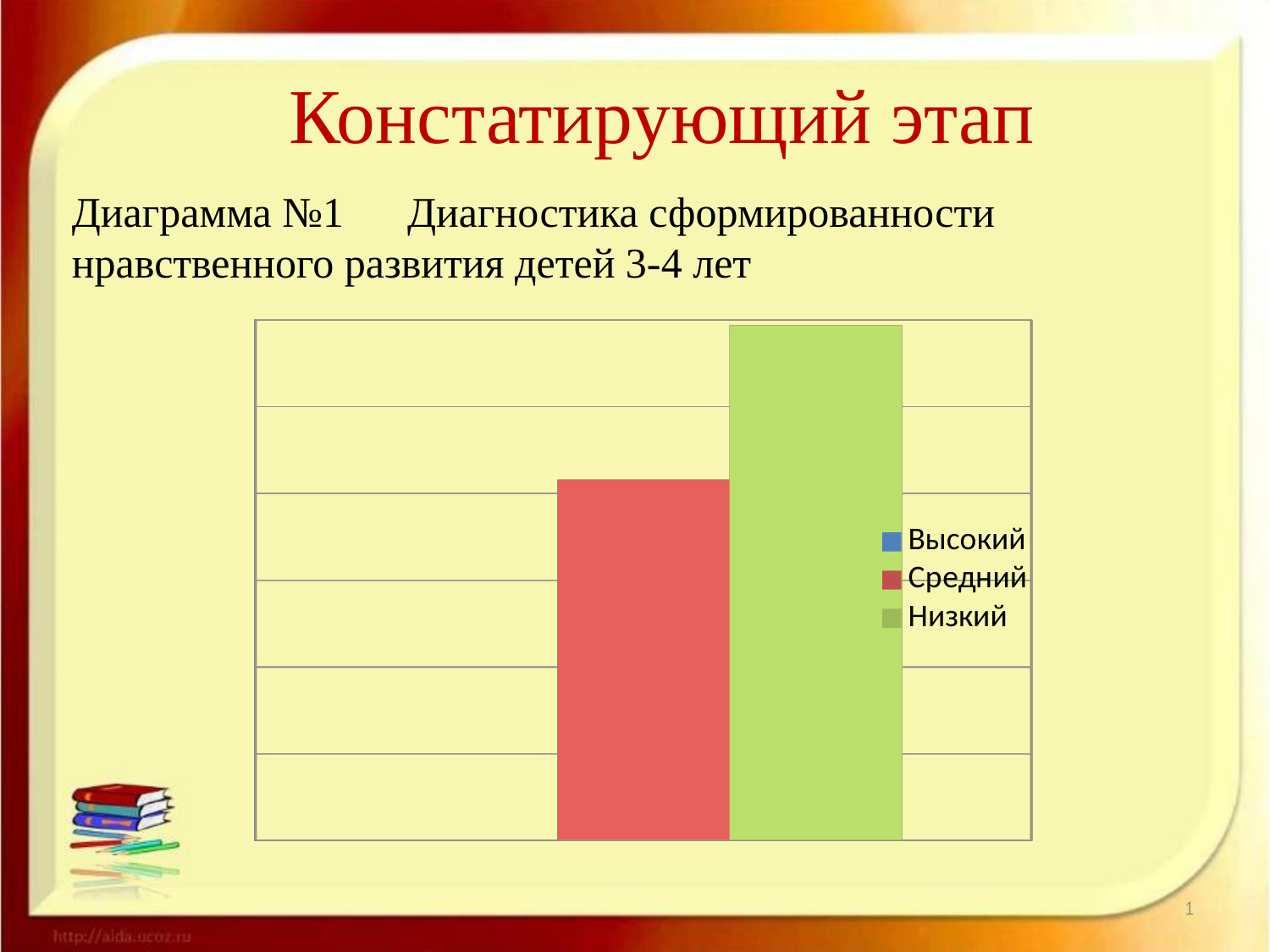
Which is larger, the bar for Средний or the bar for Низкий? Низкий What kind of chart is shown on the slide? bar chart How many bars are visible in the chart? 2 What colour is the bar for Средний? red Which series has the tallest bar? Низкий How many series does the legend list? 3 Which series has no visible bar in the chart? Высокий